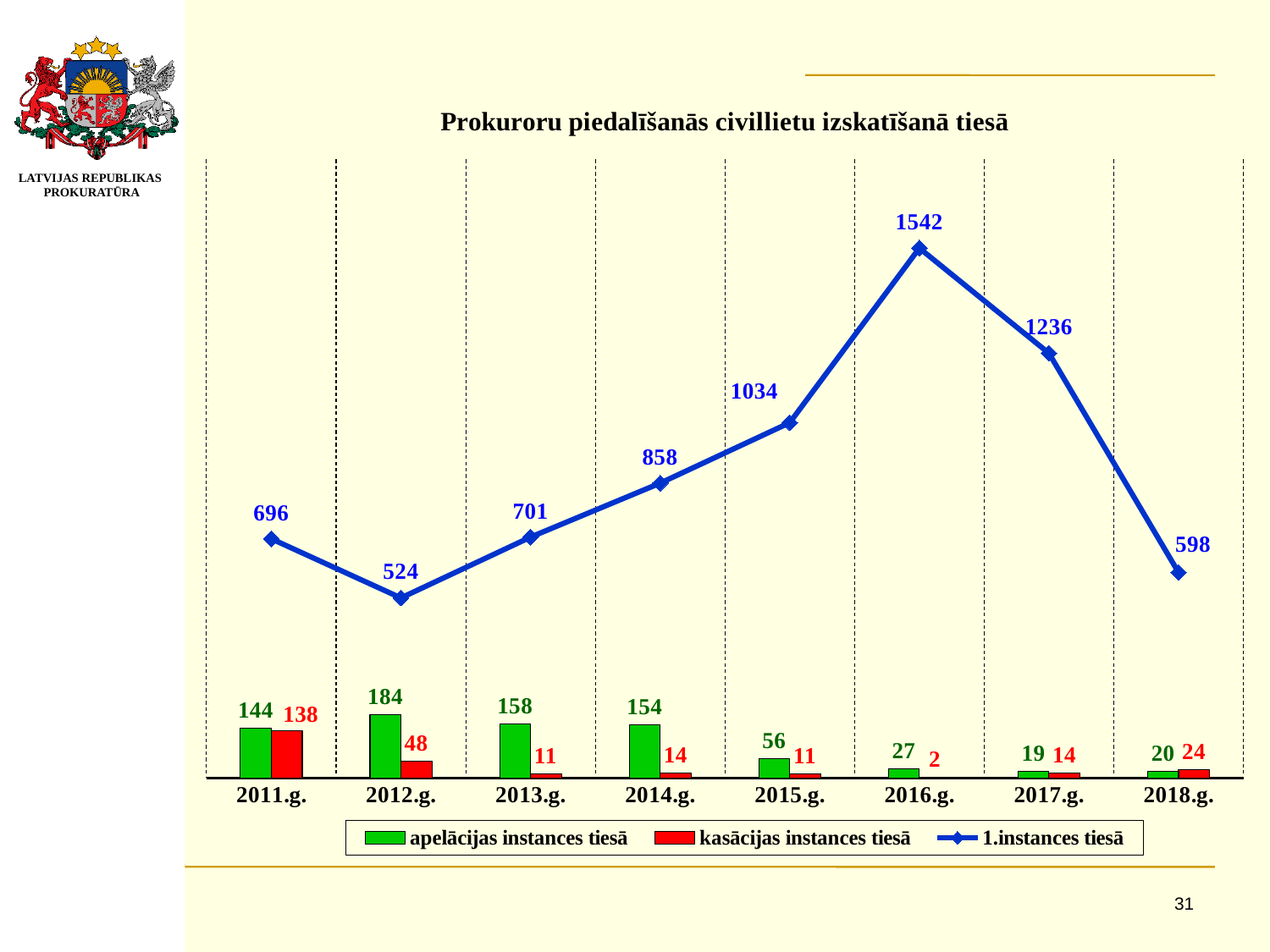
What is the difference between the 1.instances tiesā values for 2016.g. and 2017.g.? 306 In which year is the 1.instances tiesā value highest? 2016.g. What is the value for apelācijas instances tiesā in 2012.g.? 184 What is the title of the chart? Prokuroru piedalīšanās civillietu izskatīšanā tiesā Which is larger in 2018.g., apelācijas instances tiesā or kasācijas instances tiesā? kasācijas instances tiesā How many years are shown on the x axis? 8 What is the value for kasācijas instances tiesā in 2011.g.? 138 Does the 1.instances tiesā value rise or fall from 2012.g. to 2016.g.? rise How many series does the legend list? 3 What is the value for 1.instances tiesā in 2016.g.? 1542 In which year is the kasācijas instances tiesā value lowest? 2016.g. In which year is the 1.instances tiesā value lowest? 2012.g.